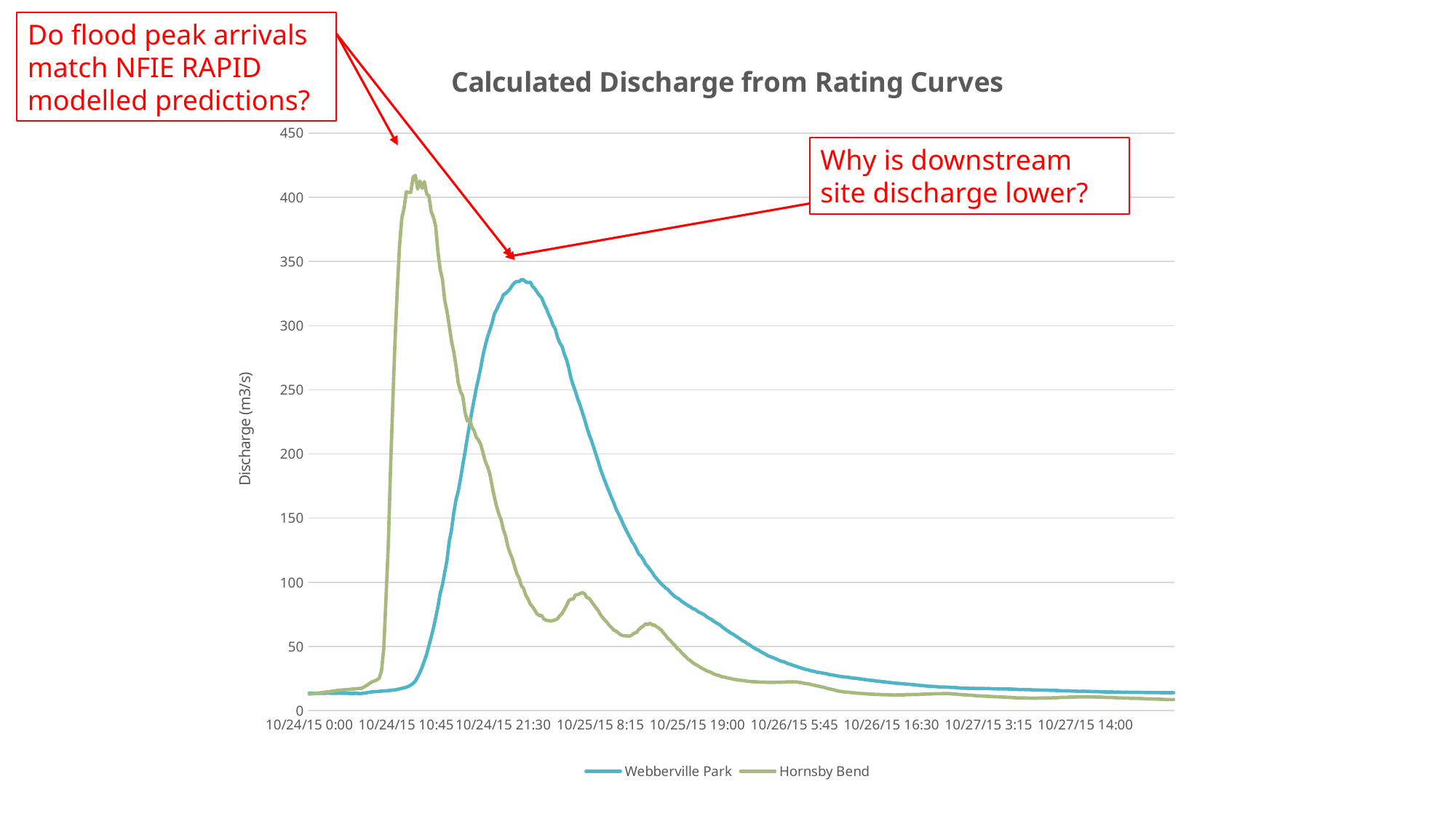
Is the value for Webberville Park at 10/27/15 14:00 greater or less than 50? less After its peak, does the Webberville Park discharge rise or fall along the x axis? fall Which series reaches the higher peak discharge, Webberville Park or Hornsby Bend? Hornsby Bend How many series does the legend list? 2 What kind of chart is shown on the slide? line chart How many date-time labels are shown on the x axis? 8 Is the peak value for Hornsby Bend greater or less than 400? greater What is the label on the vertical axis? Discharge (m3/s) Is the peak value for Webberville Park greater or less than 300? greater What is the title of the chart? Calculated Discharge from Rating Curves Which series reaches its peak earlier in time, Webberville Park or Hornsby Bend? Hornsby Bend